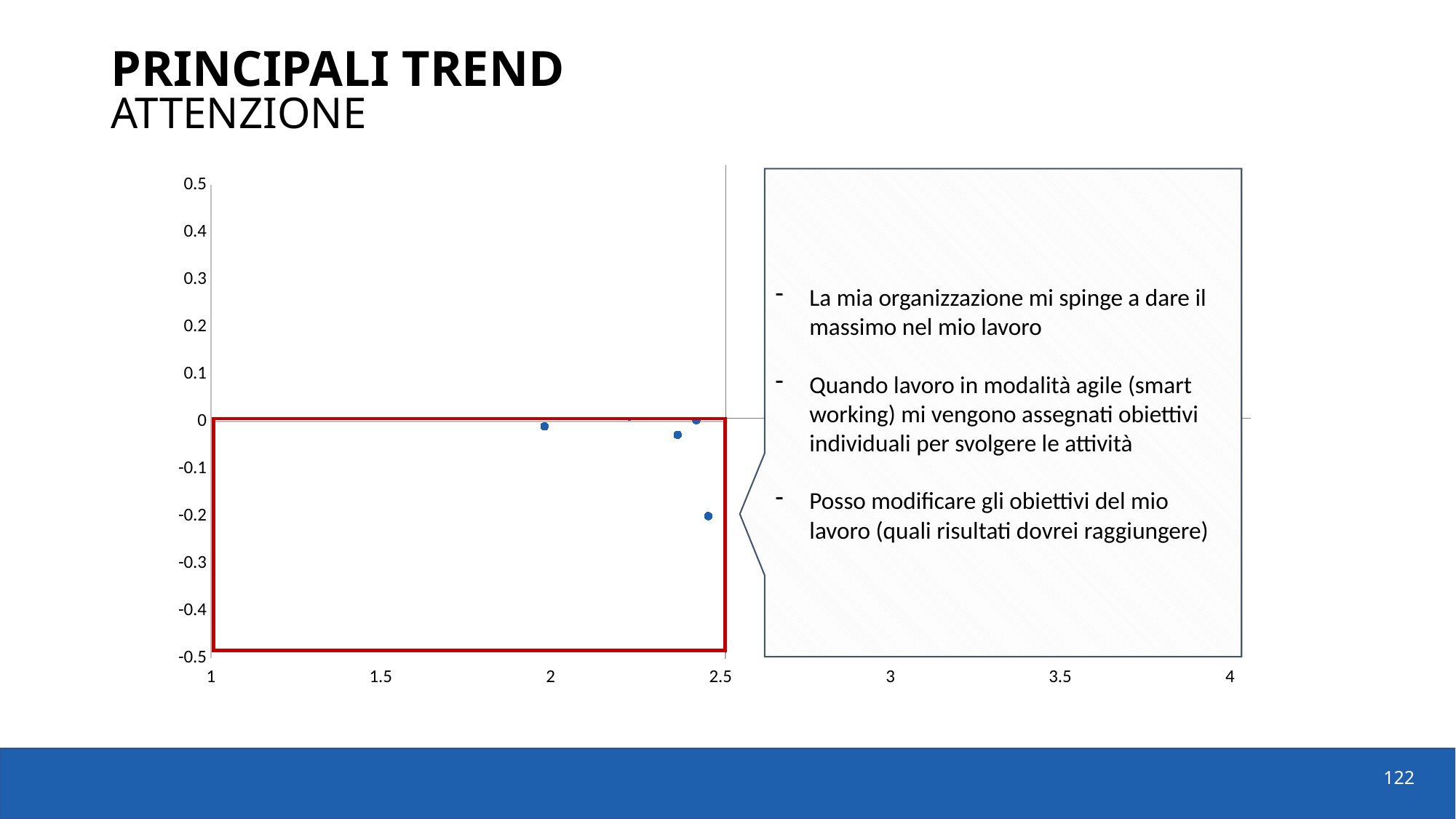
What kind of chart is shown on the slide? scatter chart Is the x value of the leftmost visible data point greater or less than 1.5? greater What is the highest value shown on the chart's x axis? 4 How many data points are visible inside the red box on the chart? 4 What is the highest value shown on the chart's y axis? 0.5 Is the lowest visible data point on the chart greater or less than -0.1 on the y axis? less